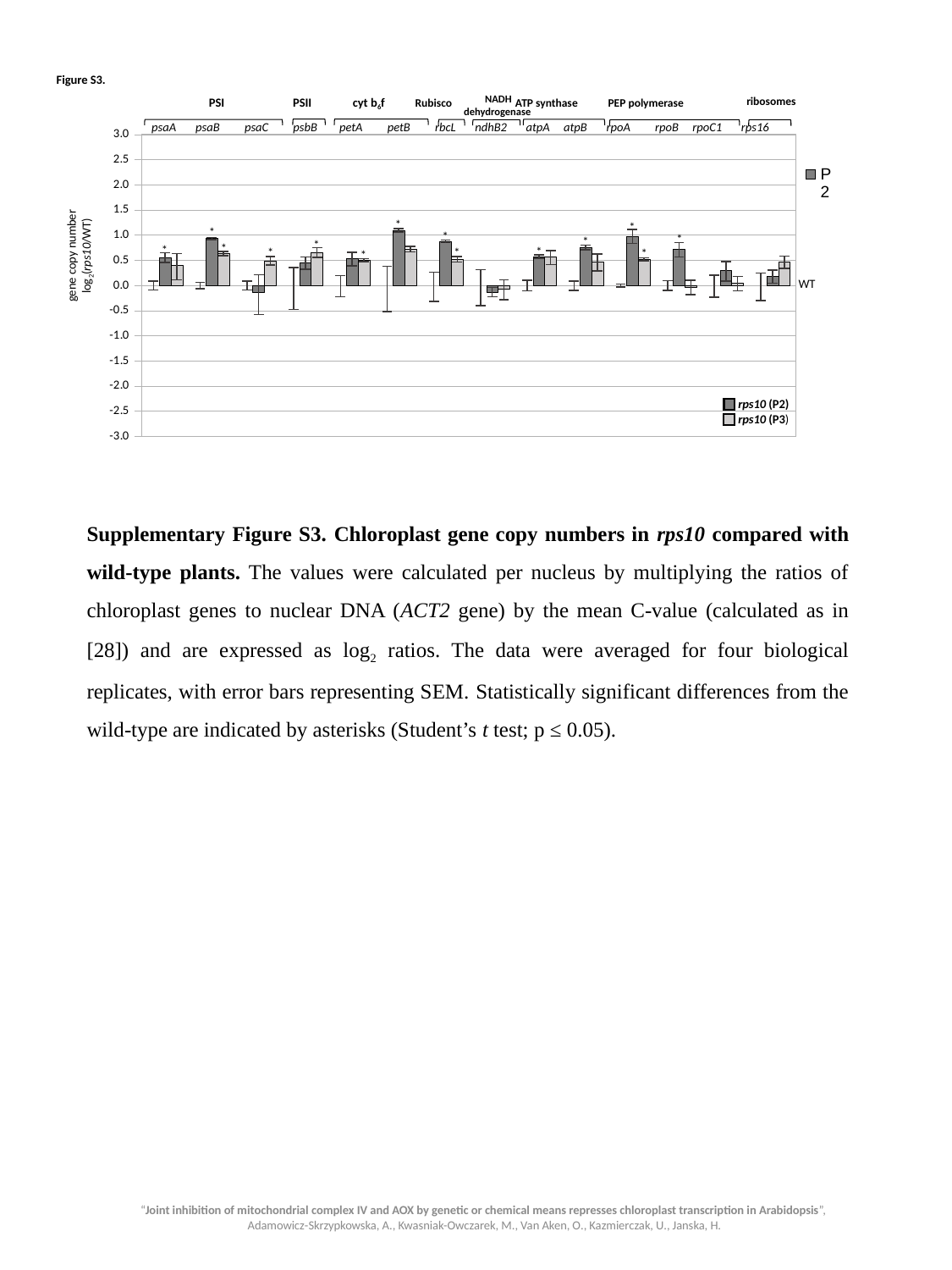
Is the rps10 (P2) value for petB greater or less than 1.0? greater Which is larger, the rps10 (P2) value for psaB or for psaC? psaB Is the rps10 (P2) value for psaB greater or less than 0.5? greater What kind of chart is shown on the slide? bar chart Is the rps10 (P2) value for rpoC1 greater or less than 0.5? less Which genes are grouped under the PEP polymerase label? rpoA, rpoB, rpoC1 Which gene has the highest rps10 (P2) bar? petB How many gene categories are plotted along the x axis? 14 Which functional group label is shown above the petA and petB bars? cyt b6f How many entries does the legend box at the bottom right of the chart list? 2